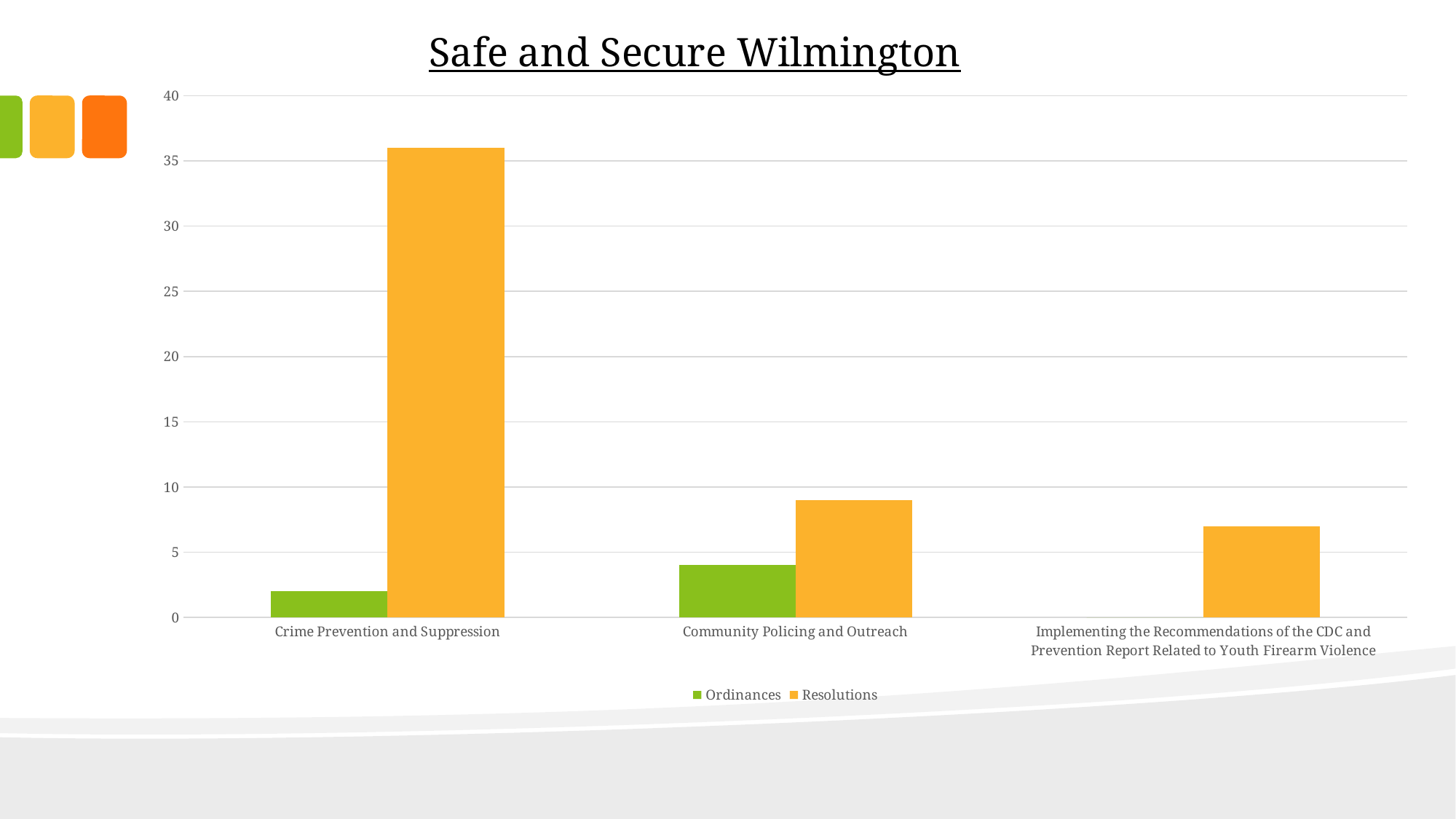
Which category has the highest Ordinances value? Community Policing and Outreach For Community Policing and Outreach, which is larger: Ordinances or Resolutions? Resolutions Is the Resolutions value for Community Policing and Outreach greater or less than 10? less What is the title of the chart? Safe and Secure Wilmington Is the Ordinances value for Crime Prevention and Suppression greater or less than 5? less What kind of chart is shown on the slide? bar chart Is the Resolutions value for Implementing the Recommendations of the CDC and Prevention Report Related to Youth Firearm Violence greater or less than 5? greater How many series does the legend list? 2 How many categories are shown on the x axis? 3 Which category has the lowest Resolutions value? Implementing the Recommendations of the CDC and Prevention Report Related to Youth Firearm Violence Which category has the highest Resolutions value? Crime Prevention and Suppression